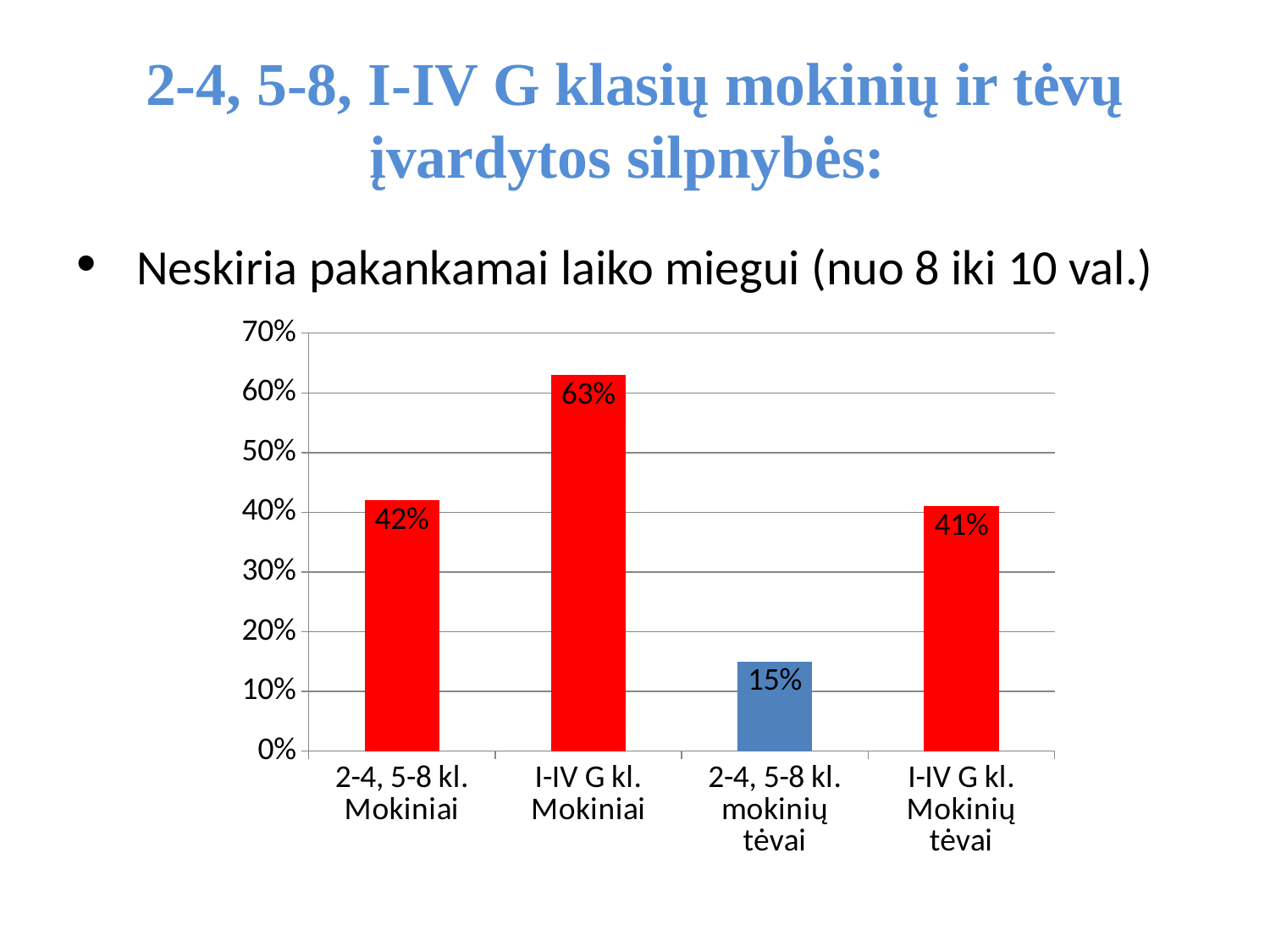
What is the value for "2-4, 5-8 kl. Mokiniai"? 42% What is the value for "I-IV G kl. Mokiniai"? 63% What is the value for "I-IV G kl. Mokinių tėvai"? 41% What kind of chart is shown on the slide? bar chart Which is larger: the value for "I-IV G kl. Mokiniai" or the value for "I-IV G kl. Mokinių tėvai"? I-IV G kl. Mokiniai Is the value for "2-4, 5-8 kl. mokinių tėvai" greater or less than 20%? less Which category has the highest value? I-IV G kl. Mokiniai What is the difference between the values for "I-IV G kl. Mokinių tėvai" and "2-4, 5-8 kl. mokinių tėvai"? 26% What is the value for "2-4, 5-8 kl. mokinių tėvai"? 15% What is the difference between the values for "I-IV G kl. Mokiniai" and "2-4, 5-8 kl. Mokiniai"? 21% Which category has the lowest value? 2-4, 5-8 kl. mokinių tėvai How many categories are shown on the chart? 4